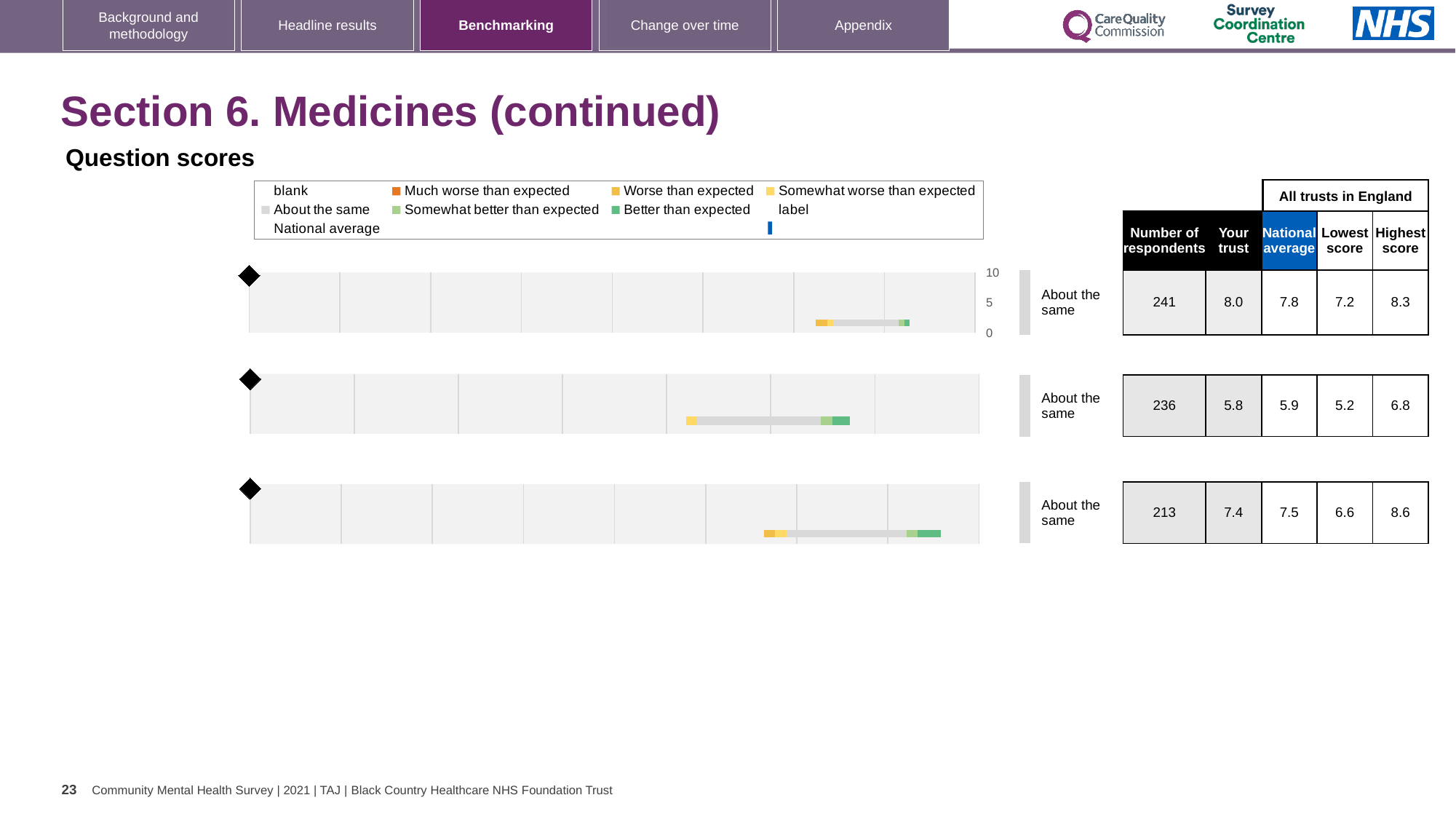
How many benchmarking charts are shown on the slide? 3 What is the maximum value shown on the score axis of the top chart? 10 Which chart row has the highest number of respondents? the top row (241) For the bottom chart row, is the 'Your trust' score or the national average larger? national average (7.5) What kind of chart is used for the benchmarking rows on this slide? bar chart Which chart row has the lowest 'Your trust' score? the middle row (5.8) How many respondents are recorded for the middle chart row? 236 What benchmark category is given for the middle chart row? About the same What is the difference between the highest score and the lowest score for the top chart row? 1.1 What is the highest score across all trusts in England for the bottom chart row? 8.6 What is the national average for the middle chart row? 5.9 What is the 'Your trust' score for the top chart row? 8.0